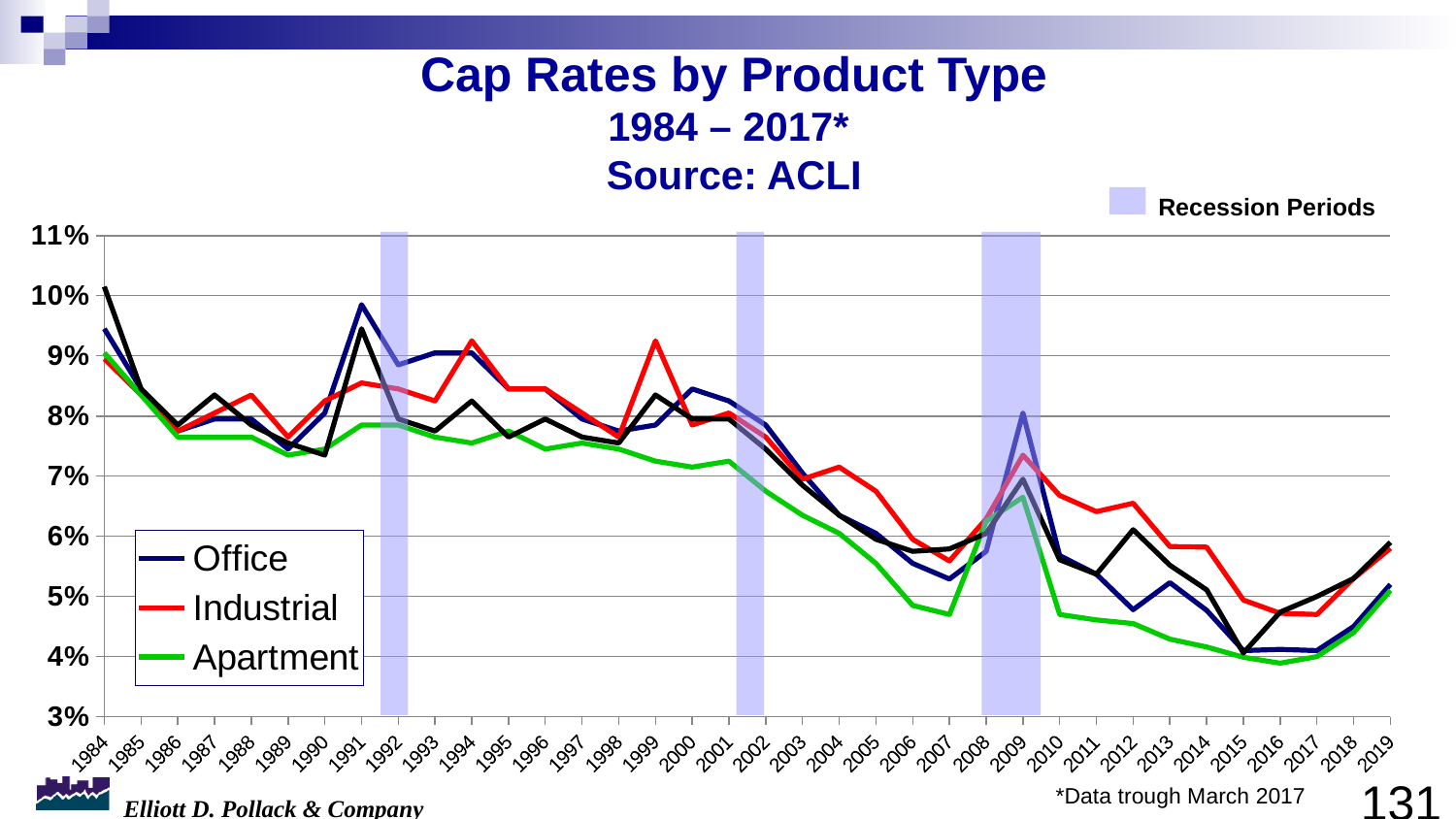
Which series has the lowest cap rate in 2016? Apartment Is the Apartment cap rate in 2006 greater or less than 5%? less Is the Apartment cap rate in 2016 greater or less than 4%? less In 2012, which series has the higher cap rate, Industrial or Office? Industrial Is the Office cap rate in 1991 greater or less than 9%? greater How many series does the legend list? 3 Which series are listed in the legend? Office, Industrial, Apartment What do the shaded vertical bands on the chart represent? Recession Periods What kind of chart is shown on the slide? Line chart How many years are labelled along the x axis? 36 Overall, do cap rates rise or fall from 1984 to 2019? fall